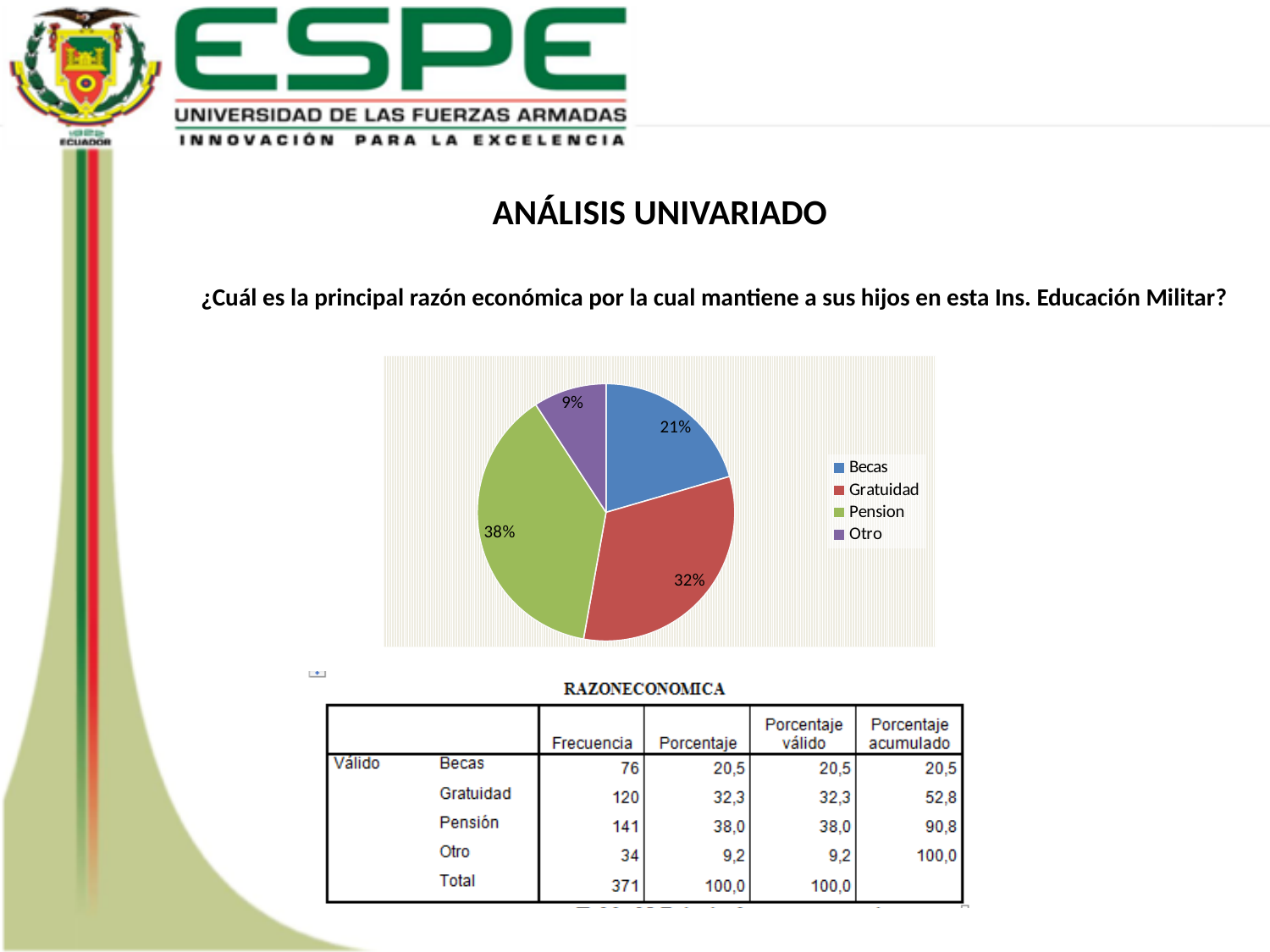
What colour is the Pension slice in the pie chart? green What percentage of the pie chart does Pension represent? 38% What percentage of the pie chart does Gratuidad represent? 32% What percentage of the pie chart does Otro represent? 9% What is the difference in percentage points between the Pension slice and the Otro slice? 29 Which is larger in the pie chart, Becas or Gratuidad? Gratuidad What percentage of the pie chart does Becas represent? 21% How many entries does the pie chart legend list? 4 How many categories are shown in the pie chart? 4 Which category has the largest slice in the pie chart? Pension What type of chart is shown on the slide? pie chart Which category has the smallest slice in the pie chart? Otro